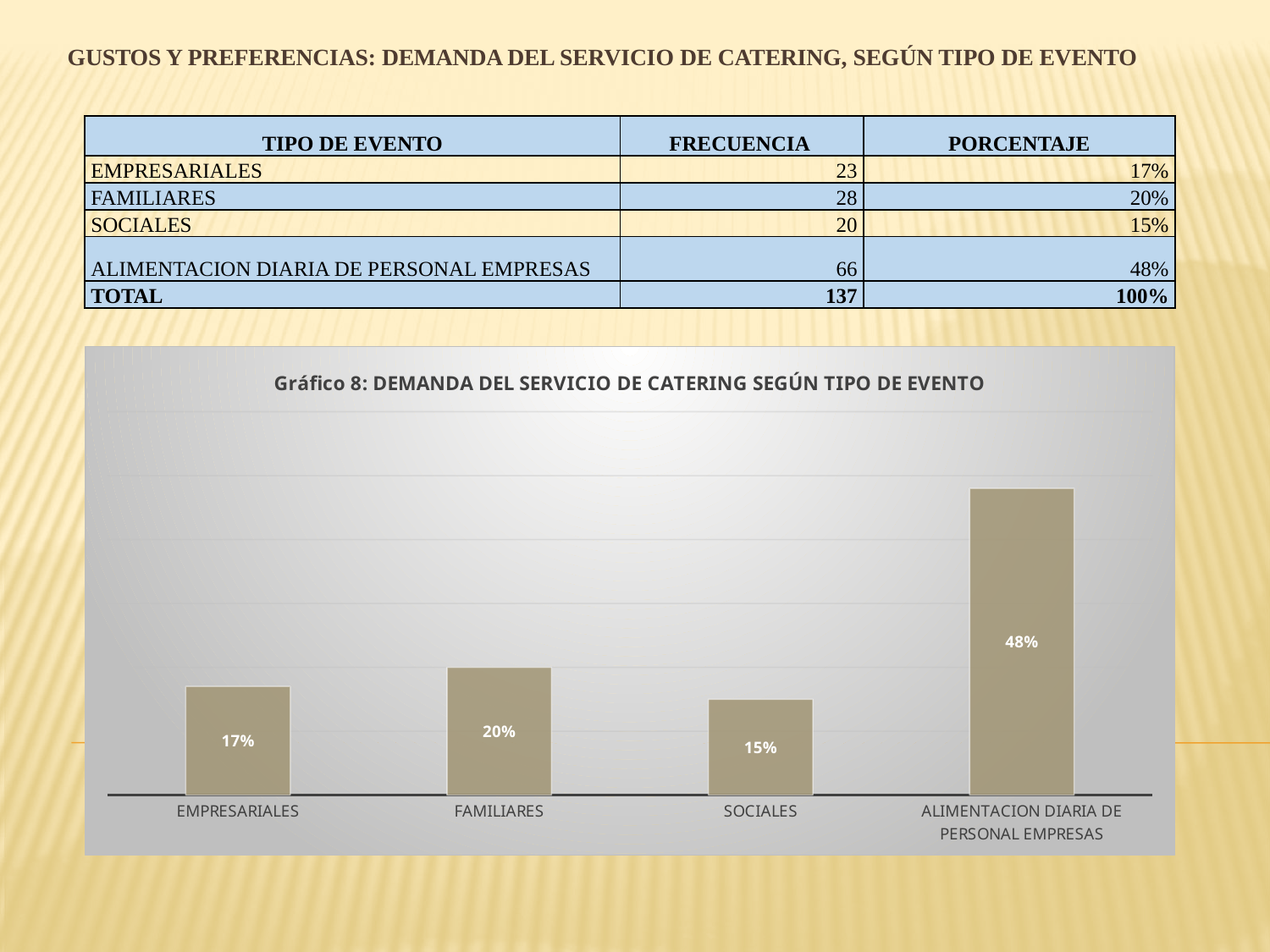
What is the value for SOCIALES in the chart? 15% Which category has the highest value in the chart? ALIMENTACION DIARIA DE PERSONAL EMPRESAS What kind of chart is shown on the slide? Bar chart How many categories are shown in the chart? 4 What is the difference between the values for ALIMENTACION DIARIA DE PERSONAL EMPRESAS and FAMILIARES? 28% What is the difference between the values for EMPRESARIALES and SOCIALES? 2% What is the value for EMPRESARIALES in the chart? 17% Which category has the lowest value in the chart? SOCIALES What is the value for FAMILIARES in the chart? 20% Which is larger, the value for FAMILIARES or the value for EMPRESARIALES? FAMILIARES What is the value for ALIMENTACION DIARIA DE PERSONAL EMPRESAS in the chart? 48% What is the title of the chart? Gráfico 8: DEMANDA DEL SERVICIO DE CATERING SEGÚN TIPO DE EVENTO